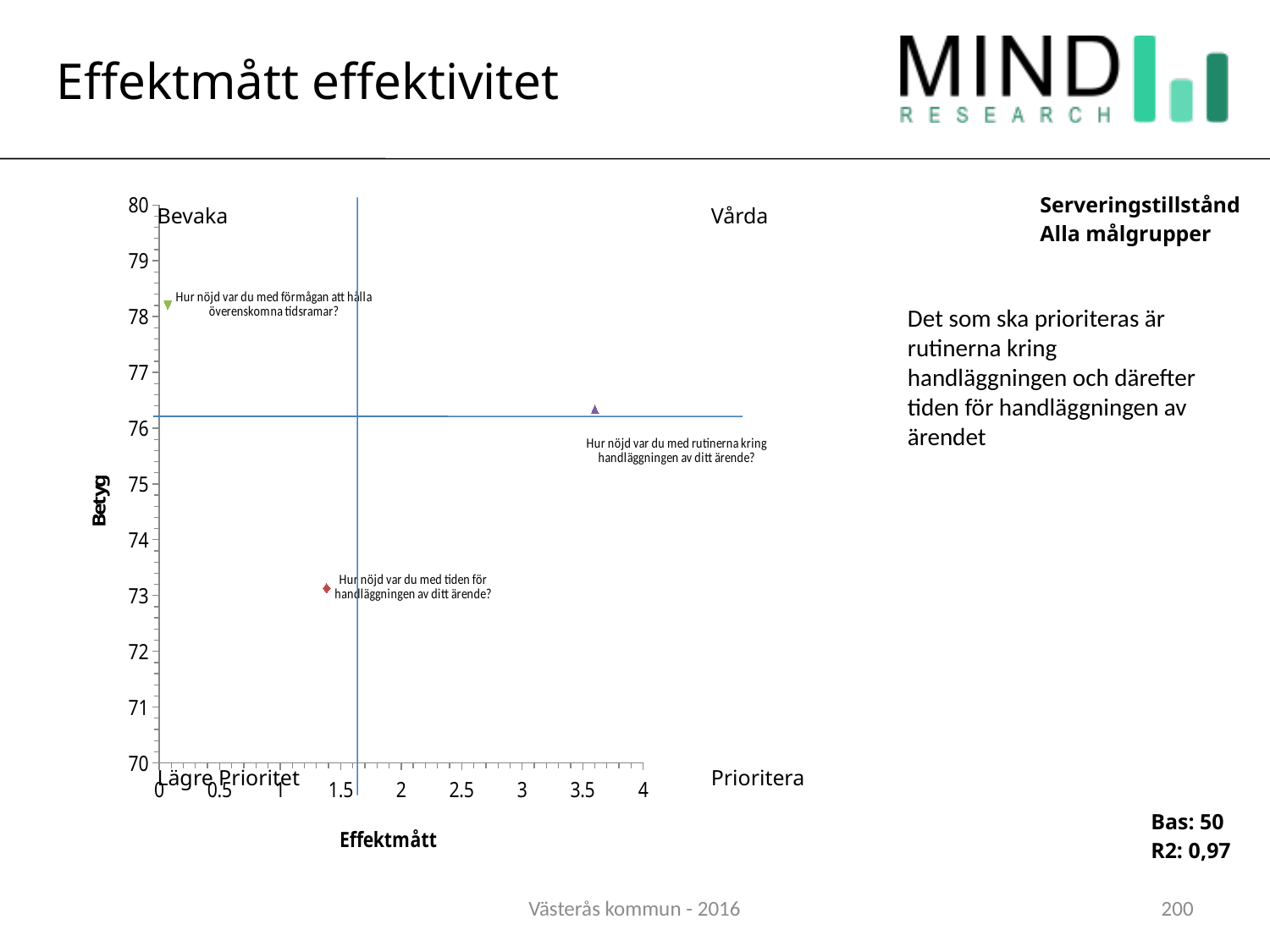
Is the Effektmått value for 'Hur nöjd var du med förmågan att hålla överenskomna tidsramar?' greater or less than 0.5? less Which question has the lowest Betyg value on the chart? Hur nöjd var du med tiden för handläggningen av ditt ärende? Is the Effektmått value for 'Hur nöjd var du med rutinerna kring handläggningen av ditt ärende?' greater or less than 3? greater Which has a higher Betyg value: 'Hur nöjd var du med rutinerna kring handläggningen av ditt ärende?' or 'Hur nöjd var du med tiden för handläggningen av ditt ärende?' Hur nöjd var du med rutinerna kring handläggningen av ditt ärende? Which question has the highest Betyg value on the chart? Hur nöjd var du med förmågan att hålla överenskomna tidsramar? Which question has the highest Effektmått value on the chart? Hur nöjd var du med rutinerna kring handläggningen av ditt ärende? How many data points are plotted on the chart? 3 What is the title of the vertical axis of the chart? Betyg Is the Betyg value for 'Hur nöjd var du med förmågan att hålla överenskomna tidsramar?' greater or less than 78? greater What label appears in the top-right quadrant of the chart? Vårda What kind of chart is shown on the slide? Scatter chart